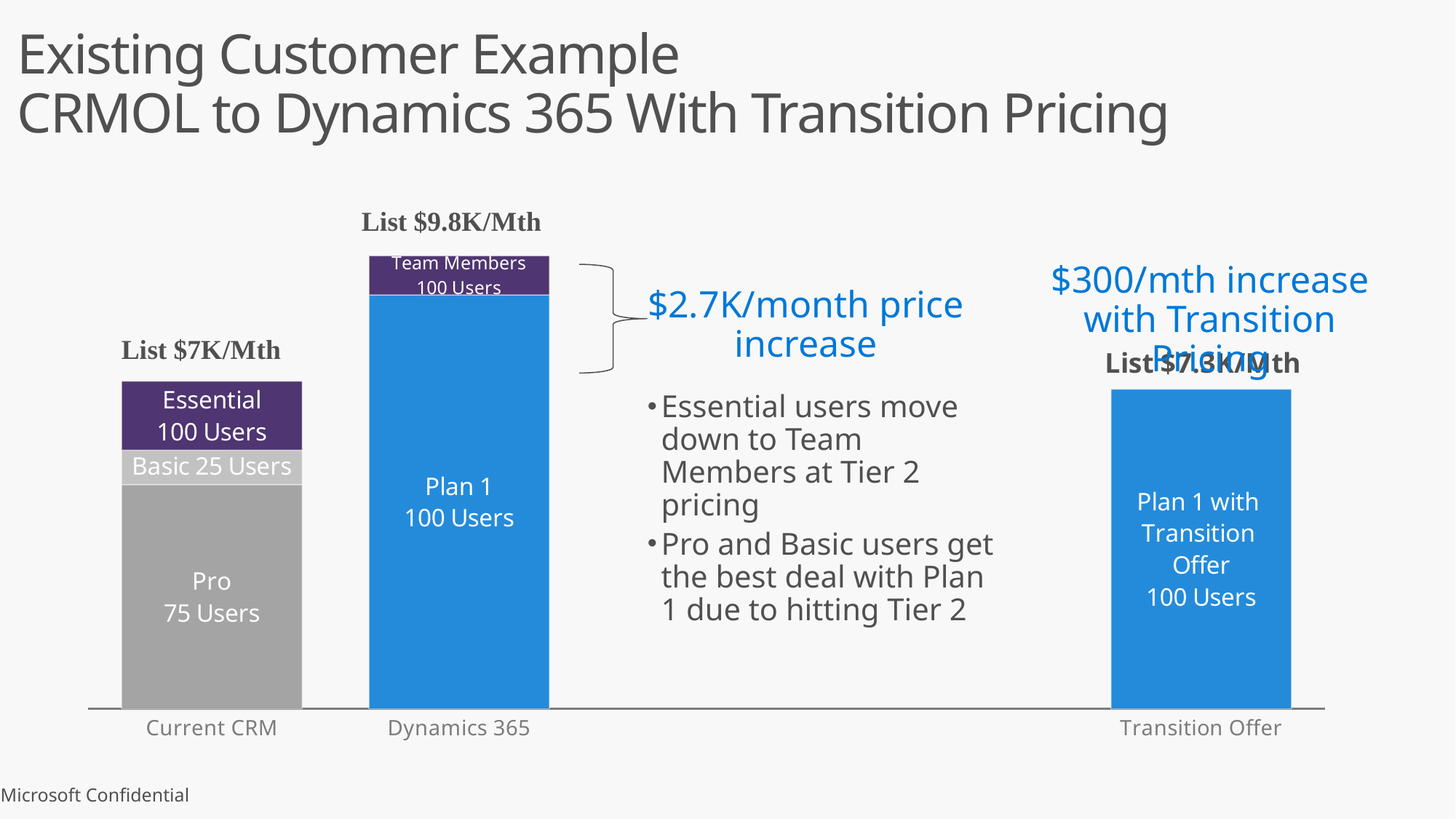
Which bar is taller, Dynamics 365 or Transition Offer? Dynamics 365 What is the list price shown above the Current CRM bar? $7K/Mth Which category has the highest list price per month? Dynamics 365 How many Basic users are shown in the Current CRM bar? 25 Users How many Pro users are shown in the Current CRM bar? 75 Users How many categories are shown along the x axis of the chart? 3 What kind of chart is shown on the slide? Stacked bar chart How many segments make up the Current CRM bar? 3 What is the list price shown above the Dynamics 365 bar? $9.8K/Mth What is the monthly price increase from Current CRM to Dynamics 365, as labelled on the slide? $2.7K/month What is the monthly price increase from Current CRM to the Transition Offer, as labelled on the slide? $300/mth Which category has the lowest list price per month? Current CRM